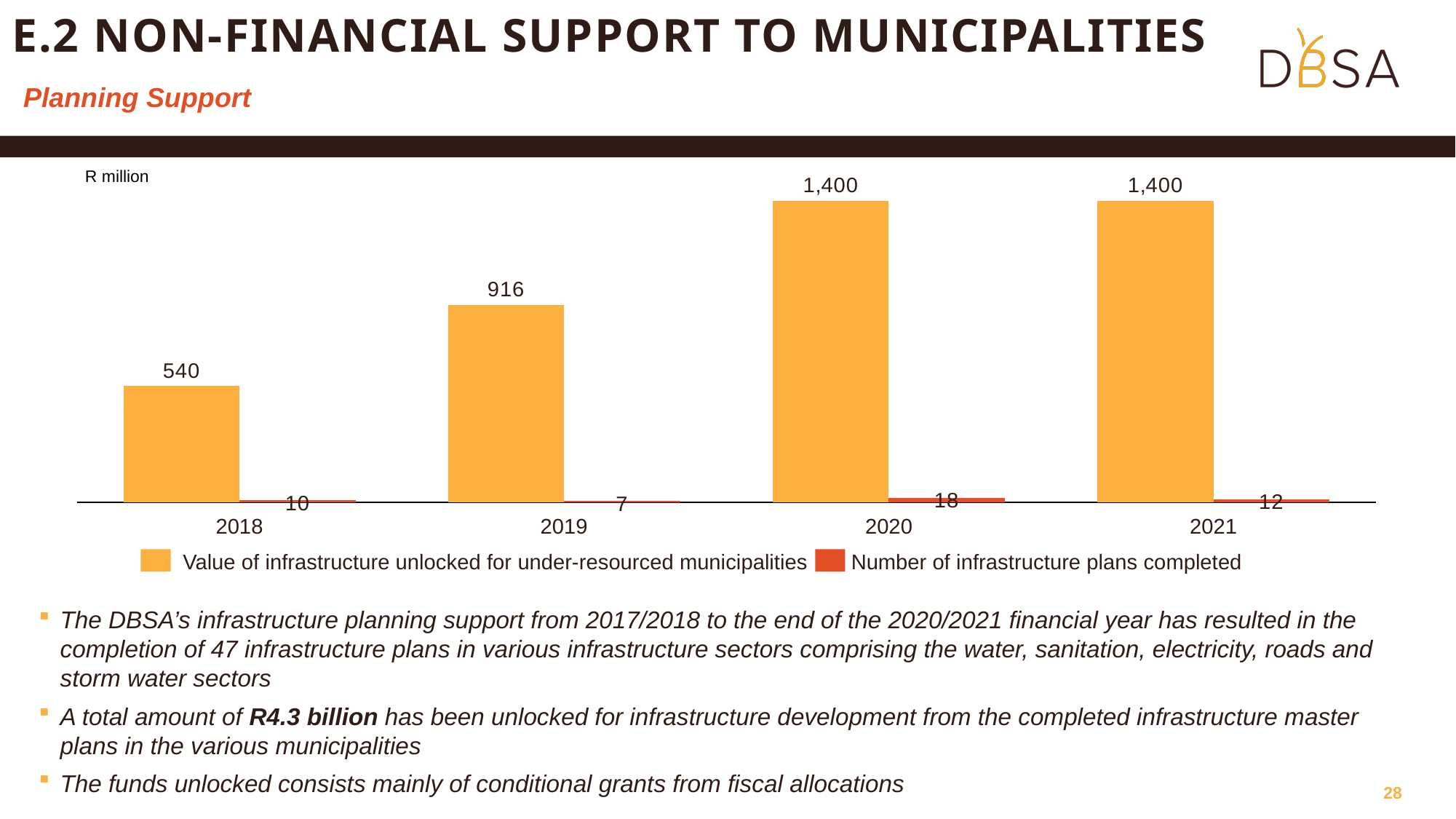
What kind of chart is shown on the slide? Bar chart What is the difference between the value of infrastructure unlocked in 2019 and in 2018? 376 How many years are shown on the x axis of the chart? 4 How many infrastructure plans were completed in 2020? 18 What is the value of infrastructure unlocked for under-resourced municipalities in 2018? 540 Which is larger: the number of infrastructure plans completed in 2018 or in 2021? 2021 Which year has the highest number of infrastructure plans completed? 2020 How many series does the chart's legend list? 2 Which year has the lowest value of infrastructure unlocked for under-resourced municipalities? 2018 What is the value of infrastructure unlocked for under-resourced municipalities in 2019? 916 Which year has the lowest number of infrastructure plans completed? 2019 How many infrastructure plans were completed in 2021? 12